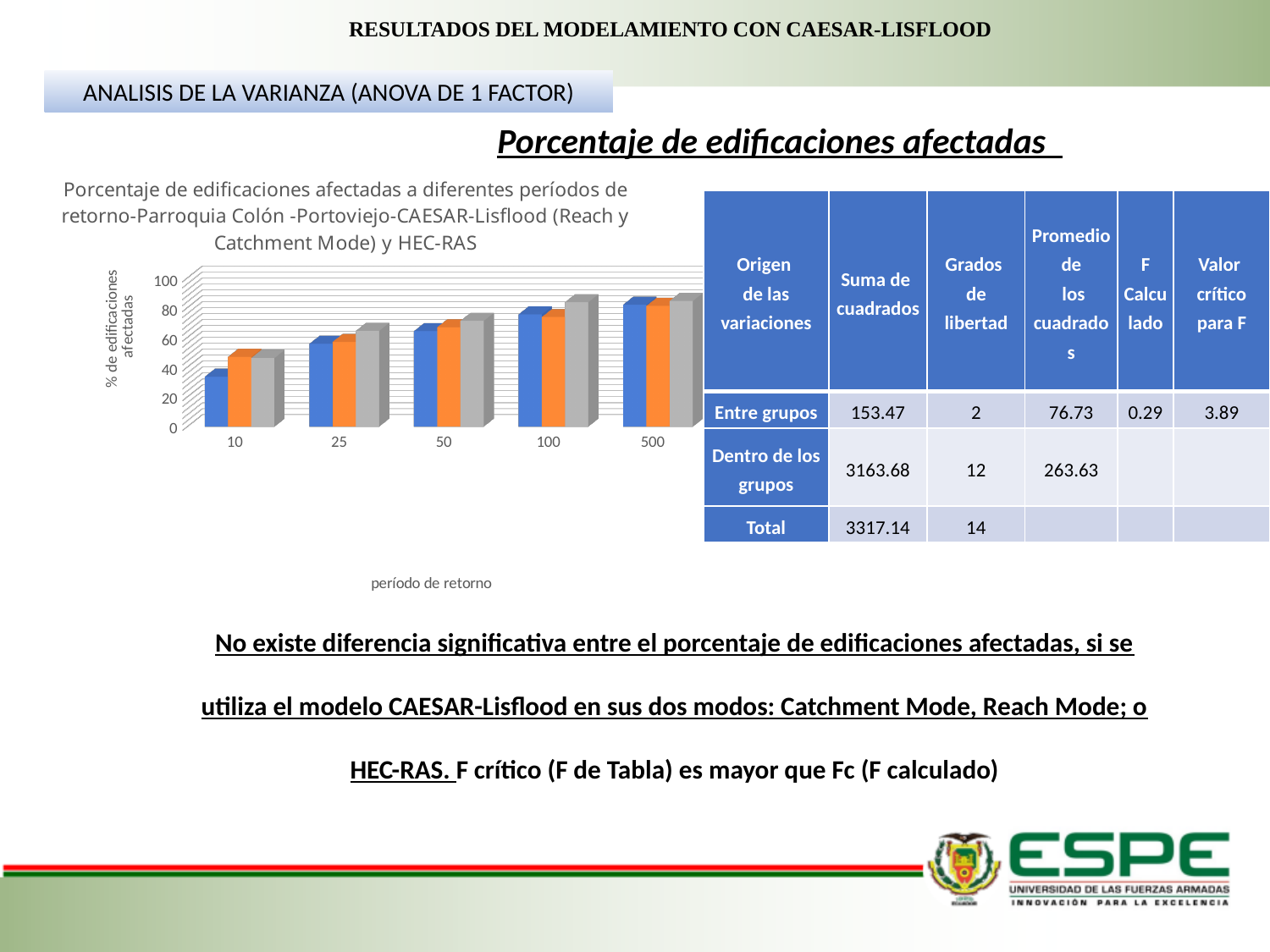
What is the label of the x axis of the chart? período de retorno Which is larger: the blue bar for return period 10 or the blue bar for return period 500? 500 What is the label of the y axis of the chart? % de edificaciones afectadas Is the blue bar for return period 500 greater or less than 60? greater What kind of chart is shown on the slide? bar chart Do the bar values rise or fall as the return period increases along the x axis? rise Which return period has the lowest blue bar in the chart? 10 Is the gray bar for return period 25 greater or less than 40? greater Is the orange bar for return period 10 greater or less than 60? less Which return period has the highest blue bar in the chart? 500 How many return-period categories are shown on the x axis of the chart? 5